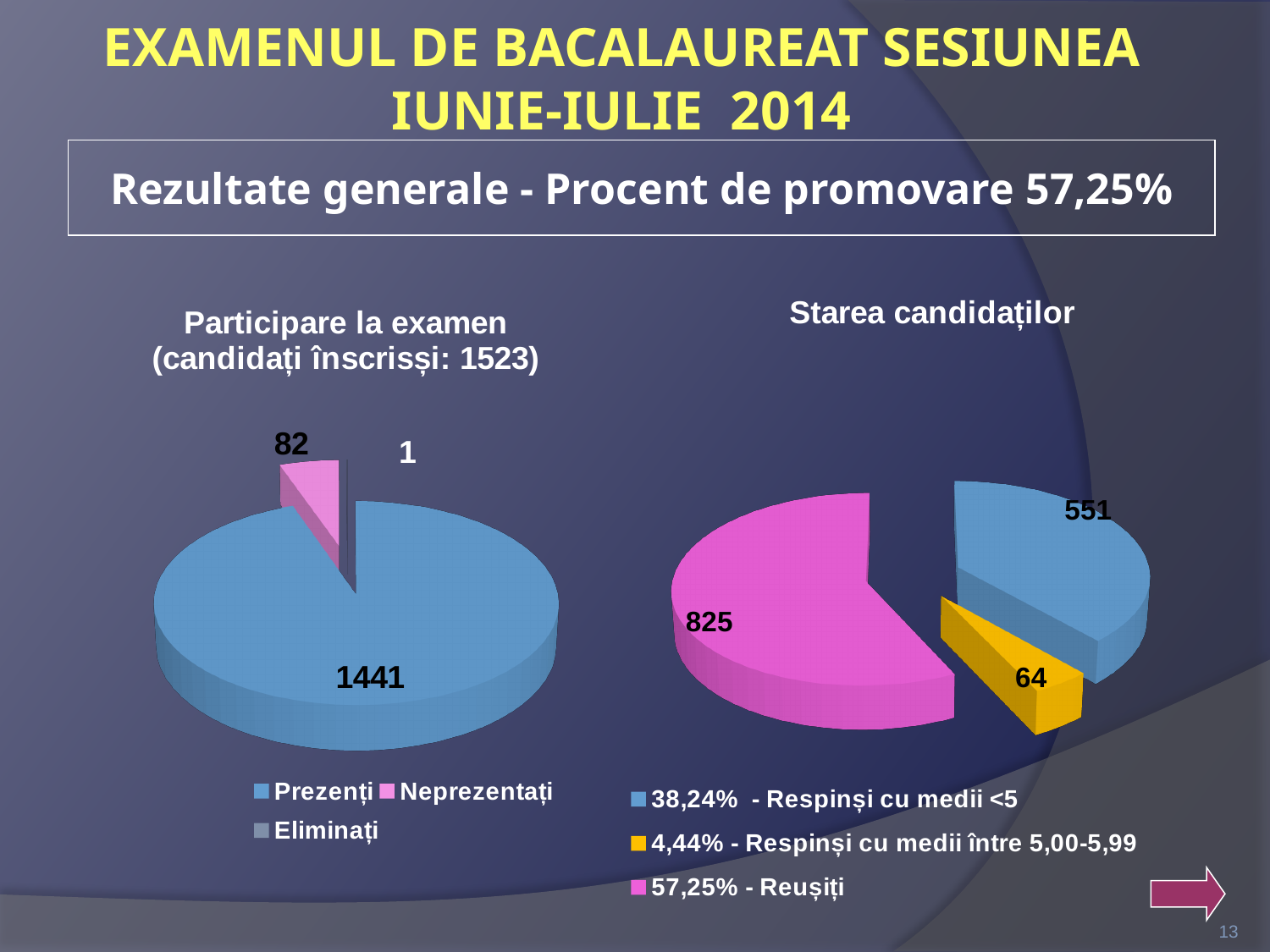
In the 'Participare la examen' chart, what is the value for Neprezentați? 82 In the 'Starea candidaților' chart, what is the value for Respinși cu medii între 5,00-5,99? 64 How many categories does the legend of the 'Participare la examen' chart list? 3 In the 'Starea candidaților' chart, what is the difference between Reușiți and Respinși cu medii <5? 274 In the 'Starea candidaților' chart, which category has the largest value? Reușiți In the 'Participare la examen' chart, what is the value for Prezenți? 1441 In the 'Participare la examen' chart, which category has the smallest value? Eliminați In the 'Starea candidaților' chart, what is the value for Reușiți? 825 In the 'Participare la examen' chart, what is the difference between Prezenți and Neprezentați? 1359 In the 'Starea candidaților' chart, what share of the pie do Respinși cu medii <5 represent? 38,24% In the 'Starea candidaților' chart, which colour represents Reușiți? pink What type of chart is used for 'Participare la examen'? pie chart